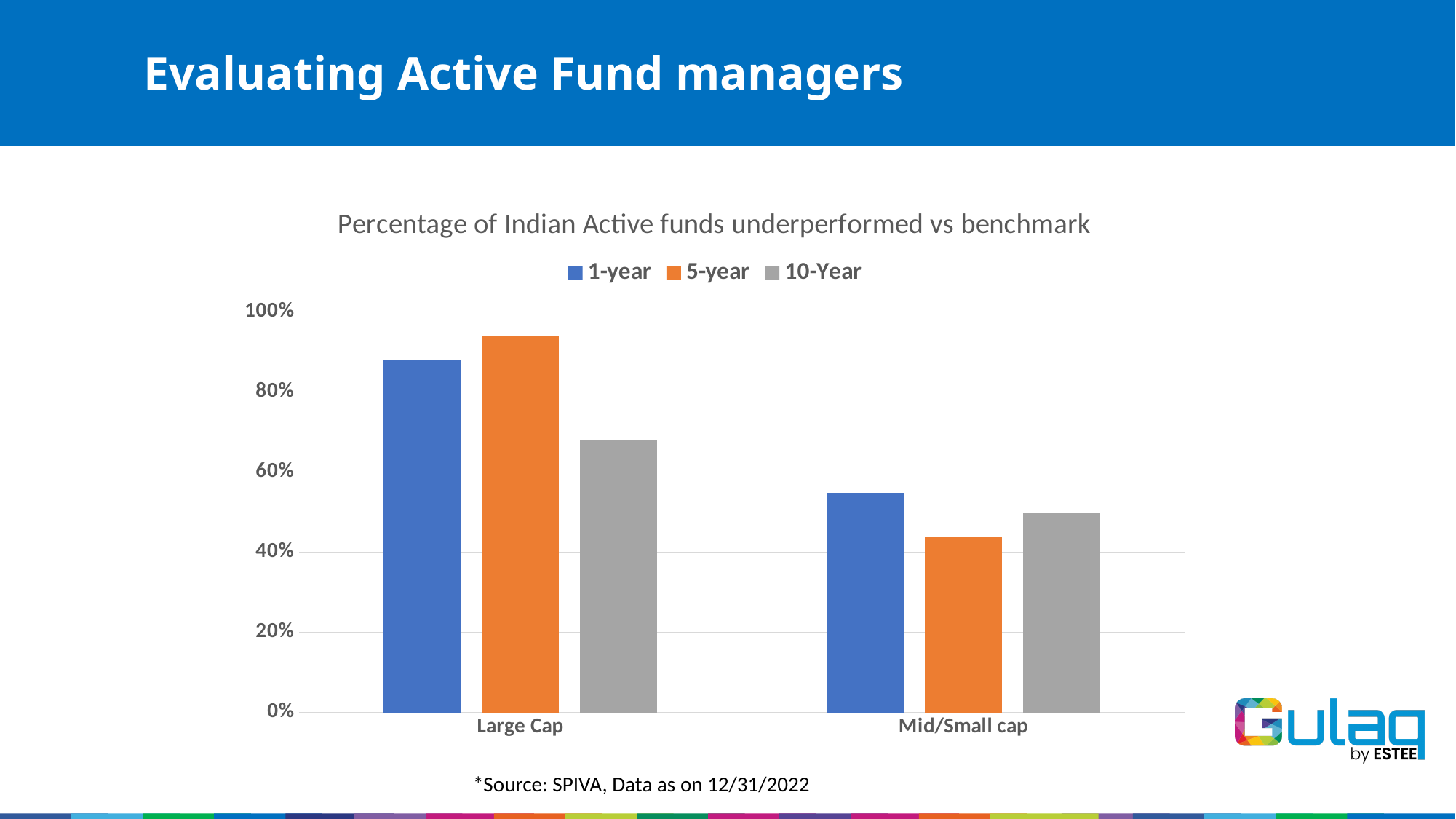
Which series has the lowest value for Large Cap? 10-Year What is the title of the chart? Percentage of Indian Active funds underperformed vs benchmark Which is larger: the 1-year value for Large Cap or the 1-year value for Mid/Small cap? Large Cap How many series does the legend list? 3 Is the 5-year value for Mid/Small cap greater or less than 60%? less Is the 5-year value for Large Cap greater or less than 80%? greater Which series has the lowest value for Mid/Small cap? 5-year What type of chart is shown on the slide? bar chart Which series has the highest value for Mid/Small cap? 1-year Is the 10-Year value for Large Cap greater or less than 80%? less Which series has the highest value for Large Cap? 5-year How many categories are shown on the x axis? 2